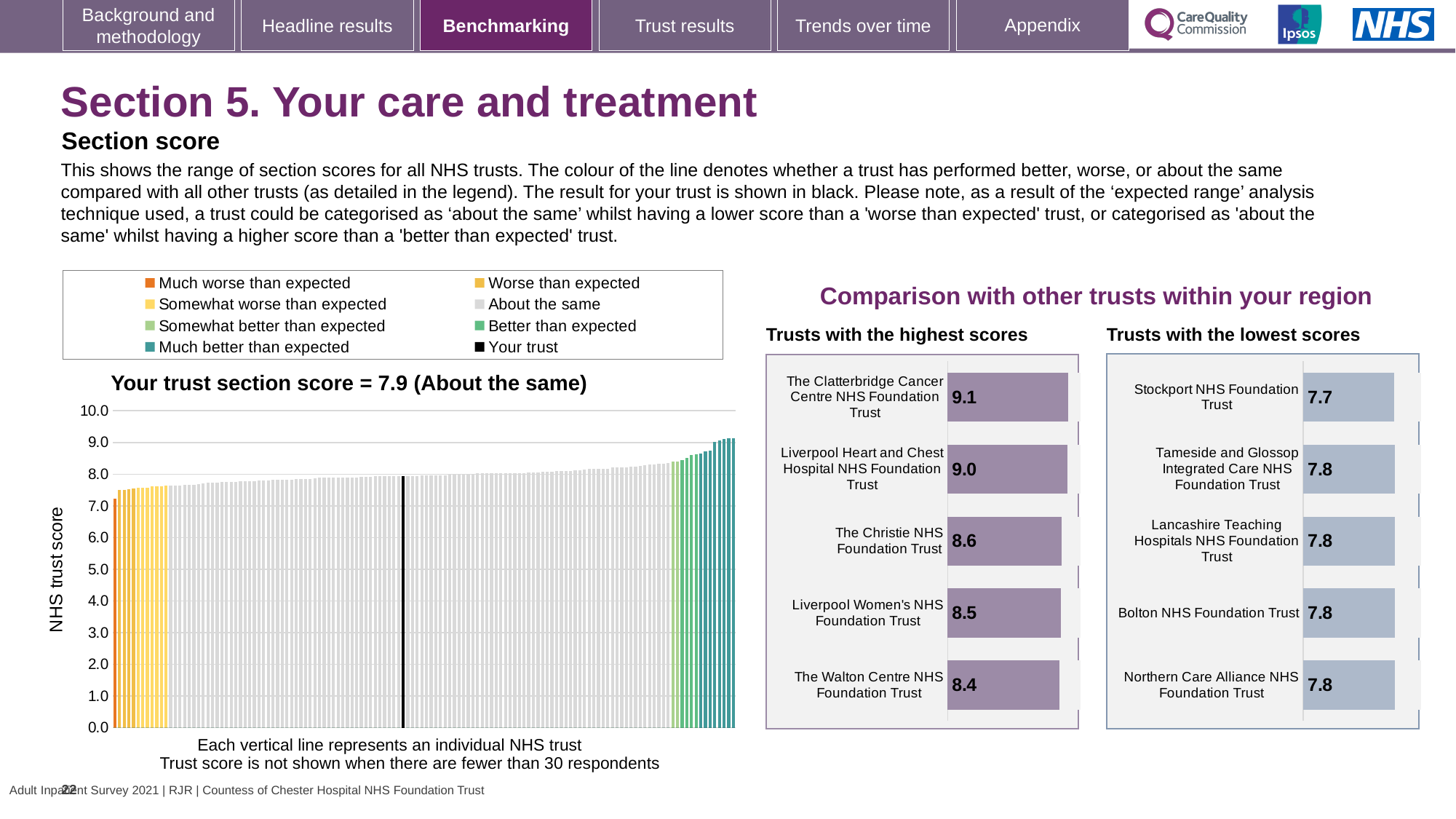
In the 'Trusts with the highest scores' chart, what is the difference between the scores of The Clatterbridge Cancer Centre NHS Foundation Trust and The Walton Centre NHS Foundation Trust? 0.7 What is the title of the chart on the left of the slide? Your trust section score = 7.9 (About the same) What is the section score for your trust shown in the title of the main chart on the left? 7.9 In the 'Trusts with the lowest scores' chart, which trust has the lowest score? Stockport NHS Foundation Trust In the 'Trusts with the highest scores' chart, what is the score for The Christie NHS Foundation Trust? 8.6 What kind of chart is the 'Trusts with the highest scores' chart? Bar chart In the 'Trusts with the highest scores' chart, which trust has the lowest score? The Walton Centre NHS Foundation Trust In the 'Trusts with the highest scores' chart, which has the higher score: Liverpool Heart and Chest Hospital NHS Foundation Trust or Liverpool Women's NHS Foundation Trust? Liverpool Heart and Chest Hospital NHS Foundation Trust How many trusts are shown in the 'Trusts with the lowest scores' chart? 5 In the 'Trusts with the lowest scores' chart, what is the score for Stockport NHS Foundation Trust? 7.7 How many entries does the legend above the main chart on the left list? 8 In the 'Trusts with the highest scores' chart, what is the score for The Clatterbridge Cancer Centre NHS Foundation Trust? 9.1